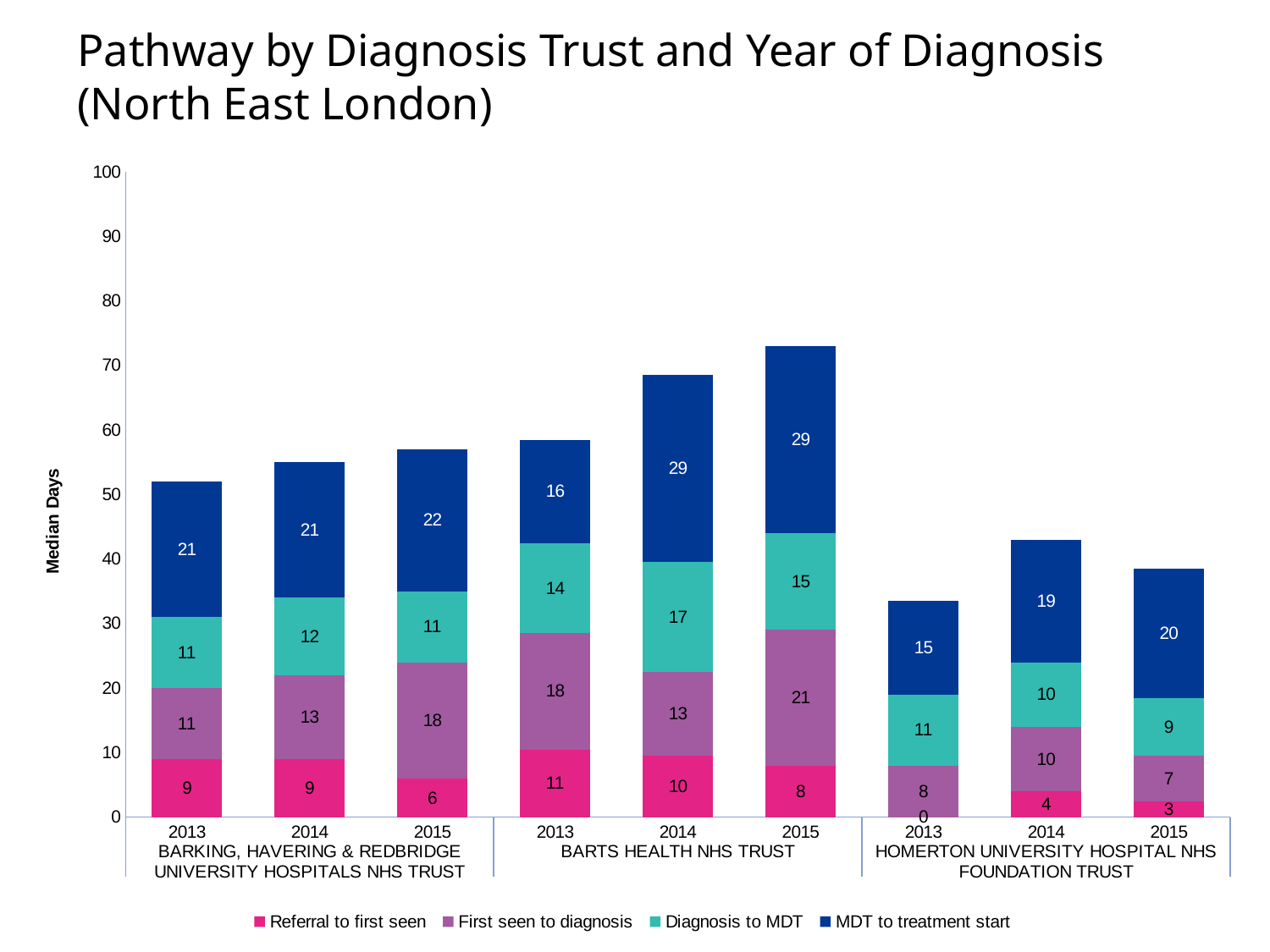
What is the MDT to treatment start value for Barts Health NHS Trust in 2014? 29 What is the difference between the Diagnosis to MDT values for Barts Health NHS Trust in 2014 and 2013? 3 What is the total of the stacked bar for Homerton University Hospital NHS Foundation Trust in 2013? 34 Do the total bar heights for Barts Health NHS Trust rise or fall from 2013 to 2015? rise How many series does the legend list? 4 What is the First seen to diagnosis value for Barking, Havering & Redbridge University Hospitals NHS Trust in 2015? 18 How many bars are plotted in the chart? 9 What is the Referral to first seen value for Homerton University Hospital NHS Foundation Trust in 2014? 4 Which trust and year has the tallest stacked bar? Barts Health NHS Trust, 2015 What is the total of the stacked bar for Barts Health NHS Trust in 2015? 73 Which trust and year has the shortest stacked bar? Homerton University Hospital NHS Foundation Trust, 2013 What kind of chart is shown on the slide? stacked bar chart